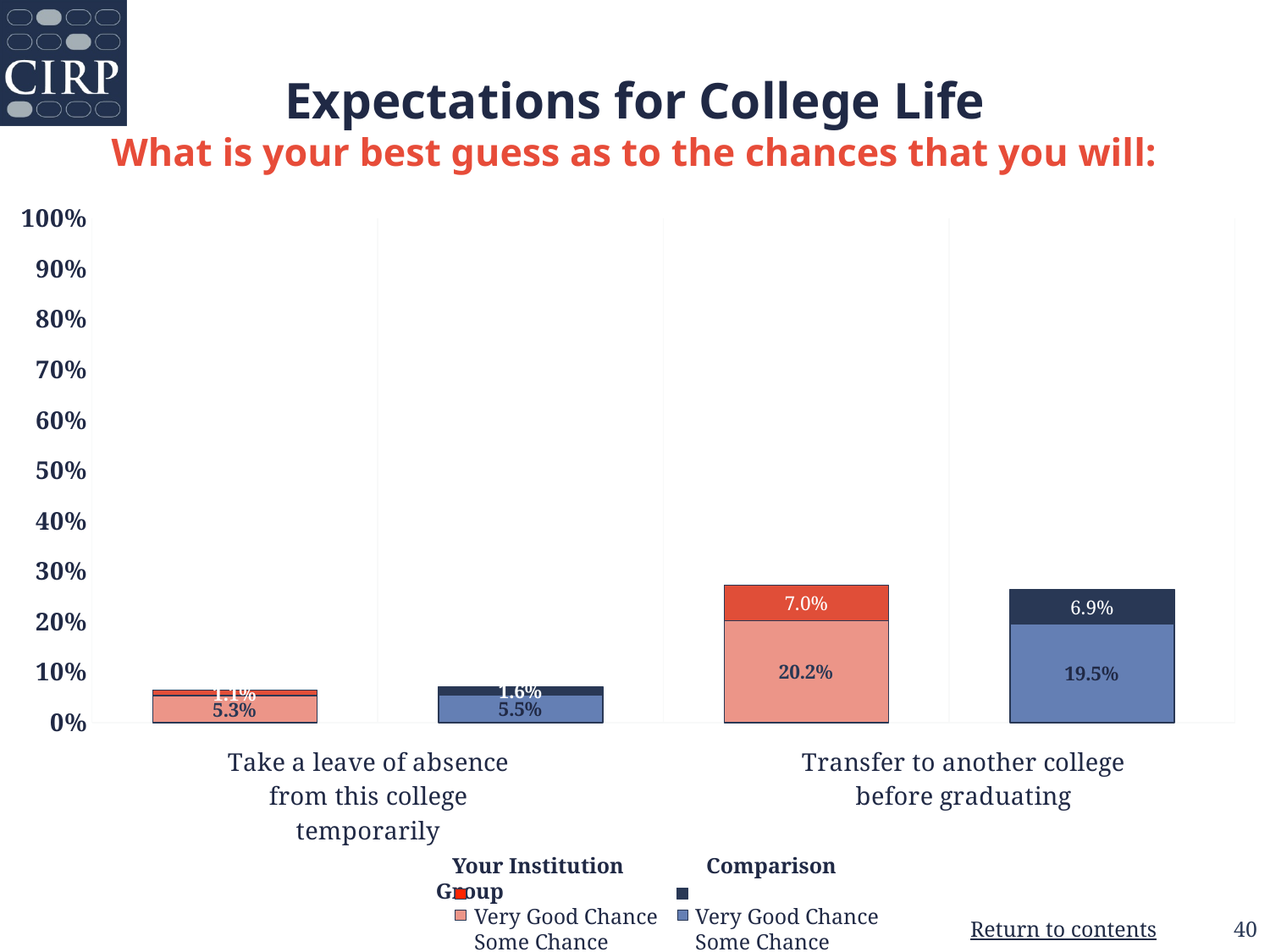
What is the Some Chance value for the Comparison Group for "Take a leave of absence from this college temporarily"? 5.5% How many categories are shown on the x axis of the chart? 2 What kind of chart is shown on the slide? Stacked bar chart What is the Very Good Chance value for the Comparison Group for "Take a leave of absence from this college temporarily"? 1.6% What is the total height of the Your Institution stacked bar for "Transfer to another college before graduating"? 27.2% What is the Some Chance value for Your Institution for "Transfer to another college before graduating"? 20.2% What is the Some Chance value for Your Institution for "Take a leave of absence from this college temporarily"? 5.3% What is the Very Good Chance value for Your Institution for "Transfer to another college before graduating"? 7.0% For "Transfer to another college before graduating", what is the difference between the Some Chance values for Your Institution and the Comparison Group? 0.7 percentage points What is the Very Good Chance value for the Comparison Group for "Transfer to another college before graduating"? 6.9% What is the total height of the Comparison Group stacked bar for "Transfer to another college before graduating"? 26.4% For "Transfer to another college before graduating", which has the larger Some Chance value: Your Institution or the Comparison Group? Your Institution